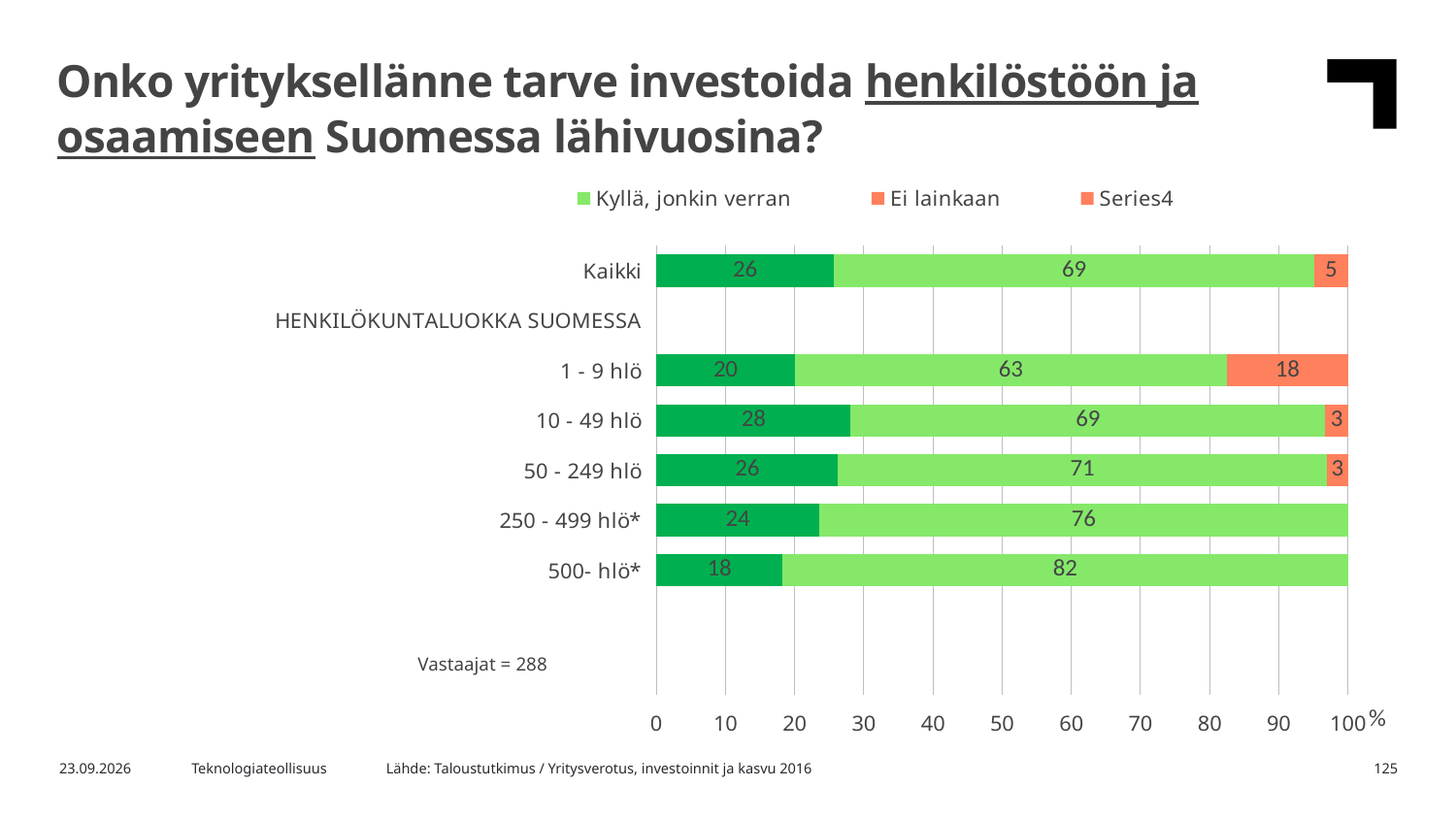
Which category has the highest "Kyllä, jonkin verran" value? 500- hlö* What is the value of the dark green first segment of the Kaikki bar? 26 What is the difference between the "Kyllä, jonkin verran" values for 500- hlö* and 1 - 9 hlö? 19 What is the total of the three labelled segments in the Kaikki bar? 100 Which has the larger "Kyllä, jonkin verran" value, 50 - 249 hlö or 10 - 49 hlö? 50 - 249 hlö Which category has the lowest "Kyllä, jonkin verran" value? 1 - 9 hlö How many bars are plotted in the chart? 6 What is the value of the "Ei lainkaan" segment for the 1 - 9 hlö category? 18 What is the value of the "Kyllä, jonkin verran" segment for the Kaikki bar? 69 How many entries does the legend list? 3 What is the value of the "Kyllä, jonkin verran" segment for the 500- hlö* category? 82 Which category has the highest "Ei lainkaan" value? 1 - 9 hlö